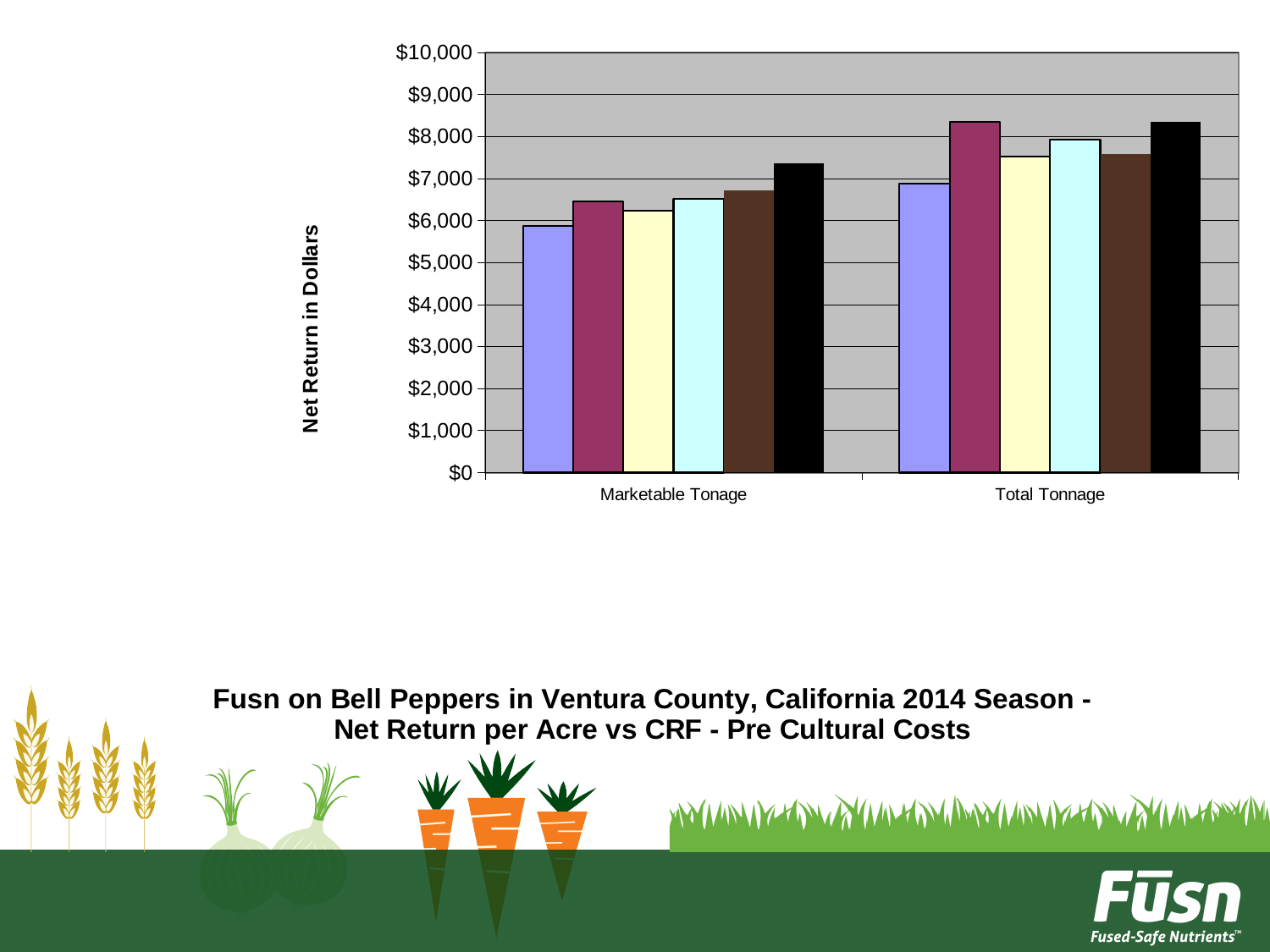
Is the value of the brown bar for Marketable Tonage greater or less than $7,000? less Is the black bar larger for Marketable Tonage or for Total Tonnage? Total Tonnage Which bar is the tallest in the Marketable Tonage category? the black bar Is the value of the pale yellow bar for Total Tonnage greater or less than $7,000? greater Is the value of the maroon bar for Total Tonnage greater or less than $8,000? greater Which bar is the shortest in the Total Tonnage category? the light purple bar What is the title text shown beneath the chart? Fusn on Bell Peppers in Ventura County, California 2014 Season - Net Return per Acre vs CRF - Pre Cultural Costs How many bars are plotted for the Marketable Tonage category? 6 What kind of chart is shown on the slide? bar chart How many categories are shown on the x axis of the chart? 2 What is the label of the vertical axis? Net Return in Dollars